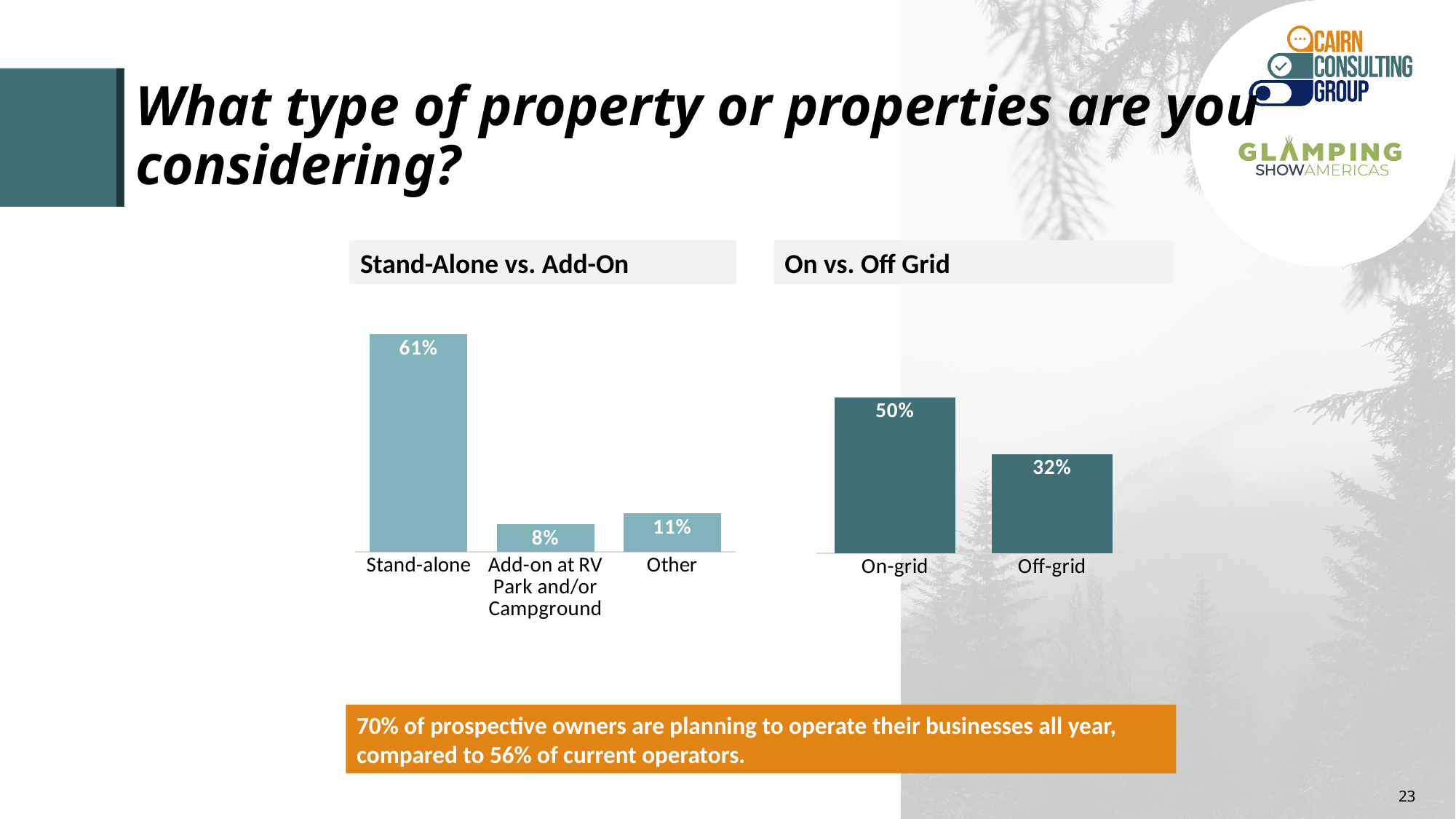
In the 'Stand-Alone vs. Add-On' chart, how many categories are shown? 3 In the 'Stand-Alone vs. Add-On' chart, what is the difference between the Stand-alone and Other values? 50% In the 'Stand-Alone vs. Add-On' chart, what is the value for Other? 11% In the 'On vs. Off Grid' chart, what is the difference between the On-grid and Off-grid values? 18% In the 'Stand-Alone vs. Add-On' chart, which category has the highest value? Stand-alone In the 'On vs. Off Grid' chart, what is the value for Off-grid? 32% In the 'Stand-Alone vs. Add-On' chart, what is the value for Add-on at RV Park and/or Campground? 8% In the 'On vs. Off Grid' chart, which is larger, On-grid or Off-grid? On-grid In the 'Stand-Alone vs. Add-On' chart, what is the value for Stand-alone? 61% In the 'Stand-Alone vs. Add-On' chart, which category has the lowest value? Add-on at RV Park and/or Campground In the 'On vs. Off Grid' chart, what is the value for On-grid? 50% What kind of chart is the 'On vs. Off Grid' chart? Bar chart